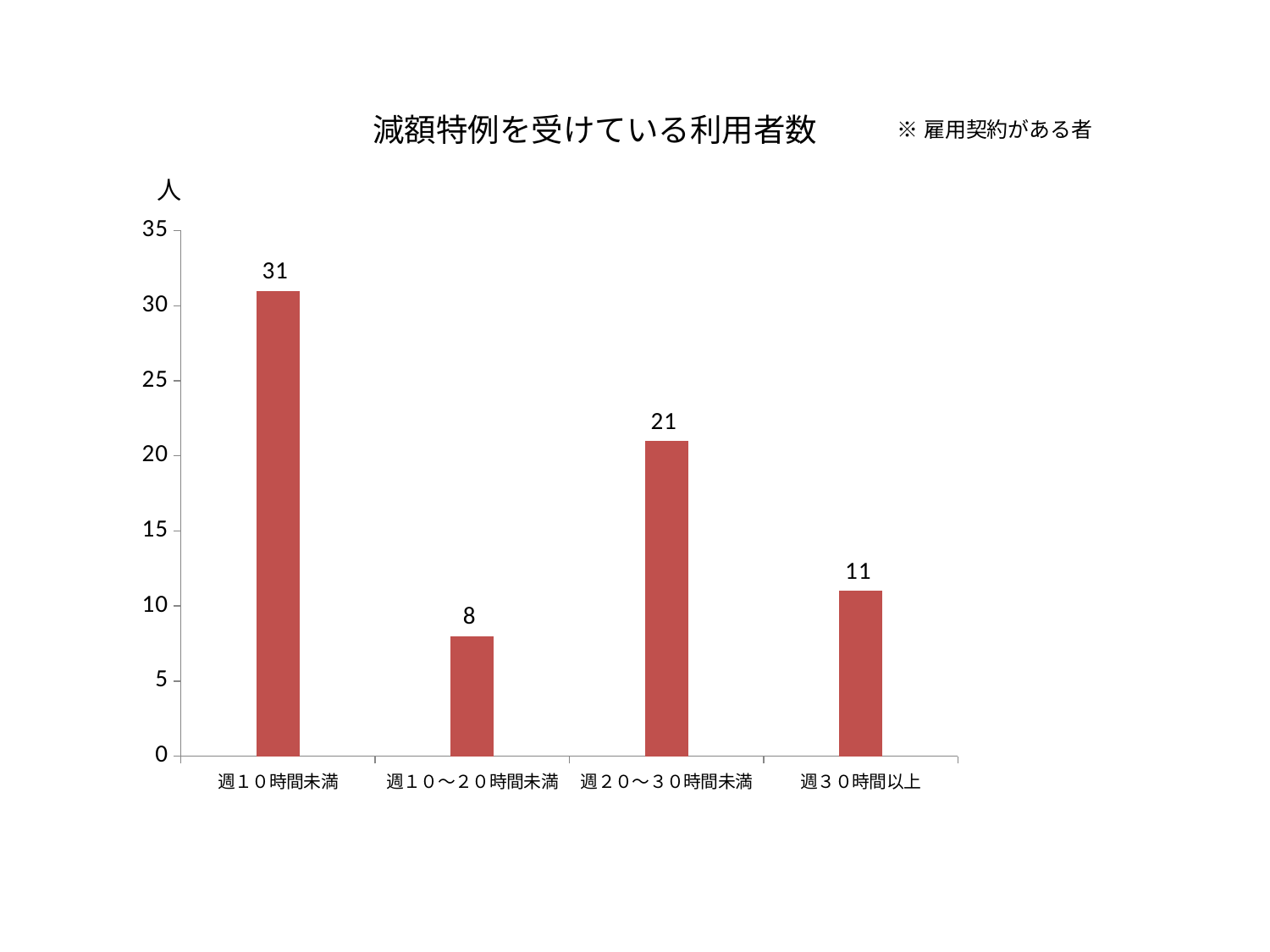
Which is larger, the value for 週２０～３０時間未満 or the value for 週３０時間以上? 週２０～３０時間未満 What kind of chart is shown on the slide? bar chart What is the difference between the values for 週１０時間未満 and 週２０～３０時間未満? 10 What is the value for 週１０時間未満? 31 How many categories are shown on the x axis? 4 Which category has the highest value? 週１０時間未満 What is the title of the chart? 減額特例を受けている利用者数 What is the value for 週３０時間以上? 11 What is the value for 週２０～３０時間未満? 21 What is the difference between the values for 週３０時間以上 and 週１０～２０時間未満? 3 Which category has the lowest value? 週１０～２０時間未満 What is the value for 週１０～２０時間未満? 8